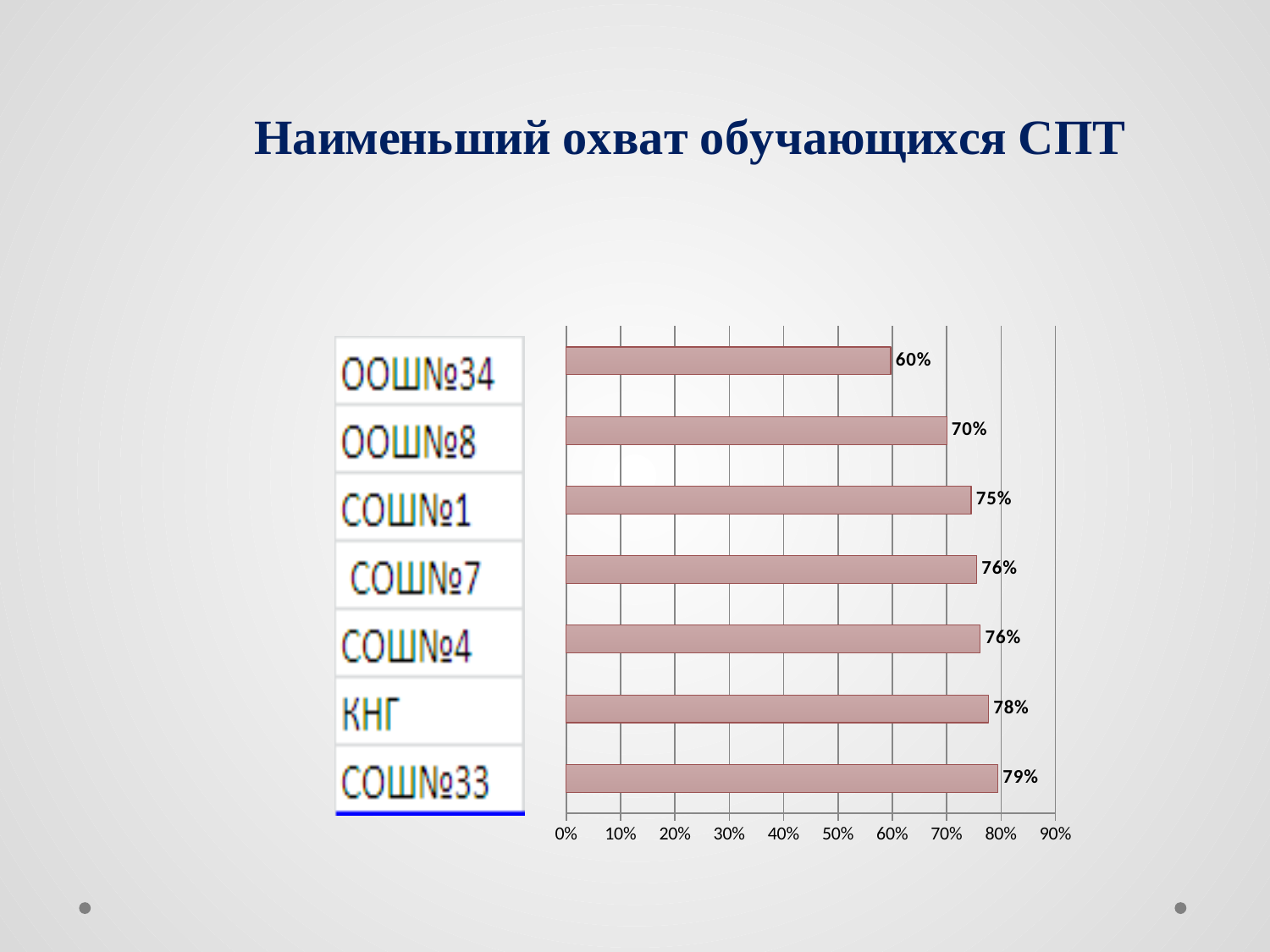
What is the value for ООШ№8? 70% What is the value for КНГ? 78% Which category has the highest value? СОШ№33 Which is larger, the value for СОШ№1 or the value for ООШ№8? СОШ№1 What kind of chart is shown on the slide? Bar chart What is the title of the slide? Наименьший охват обучающихся СПТ What is the difference between the values for СОШ№33 and ООШ№34? 19% Which category has the lowest value? ООШ№34 What is the difference between the values for КНГ and ООШ№8? 8% What is the value for СОШ№1? 75% What is the value for ООШ№34? 60% How many categories are shown in the chart? 7